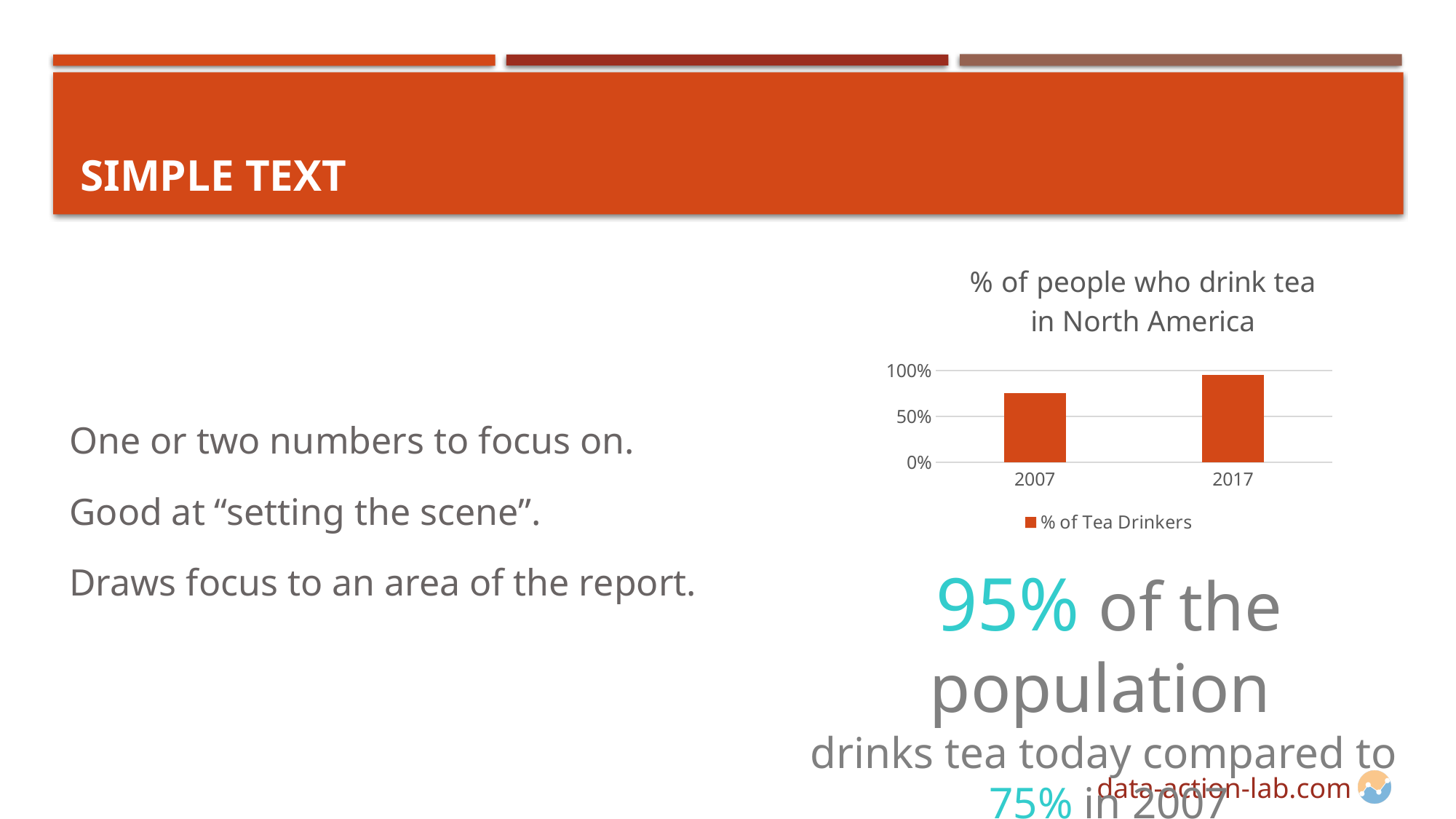
How many categories (years) are shown on the x axis of the chart? 2 What kind of chart is shown on the slide? bar chart According to the slide, what percentage of the population drank tea in 2007? 75% What is the name of the series in the chart legend? % of Tea Drinkers According to the slide, what percentage of the population drinks tea in 2017? 95% Is the value for 2017 greater or less than 50%? greater Is the value for 2007 greater or less than 50%? greater What is the title of the chart? % of people who drink tea in North America Which year has the higher percentage of tea drinkers? 2017 Do the values rise or fall from 2007 to 2017? rise Which year has the lower percentage of tea drinkers? 2007 How many series does the chart legend list? 1